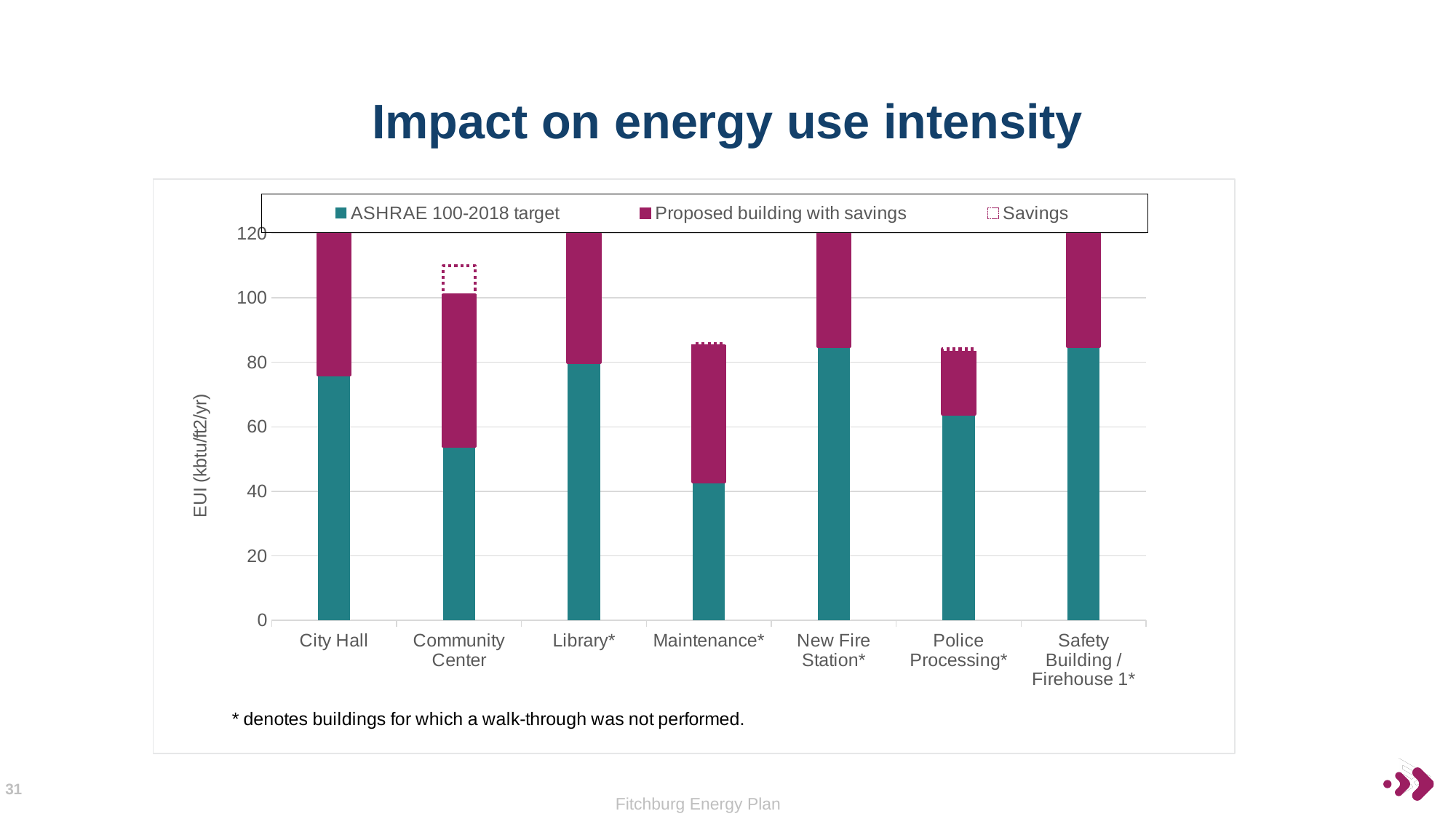
Which has the larger ASHRAE 100-2018 target value, Maintenance* or Police Processing*? Police Processing* Which has the larger ASHRAE 100-2018 target value, City Hall or Community Center? City Hall Is the ASHRAE 100-2018 target value for Maintenance* greater or less than 60? less How many series does the legend list? 3 What is the label on the y axis of the chart? EUI (kbtu/ft2/yr) Is the ASHRAE 100-2018 target value for Community Center greater or less than 60? less Is the total stacked bar for Maintenance* greater or less than 100? less What kind of chart is shown on the slide? Stacked bar chart How many buildings (categories) are shown on the x axis? 7 Which building has the lowest ASHRAE 100-2018 target value? Maintenance*